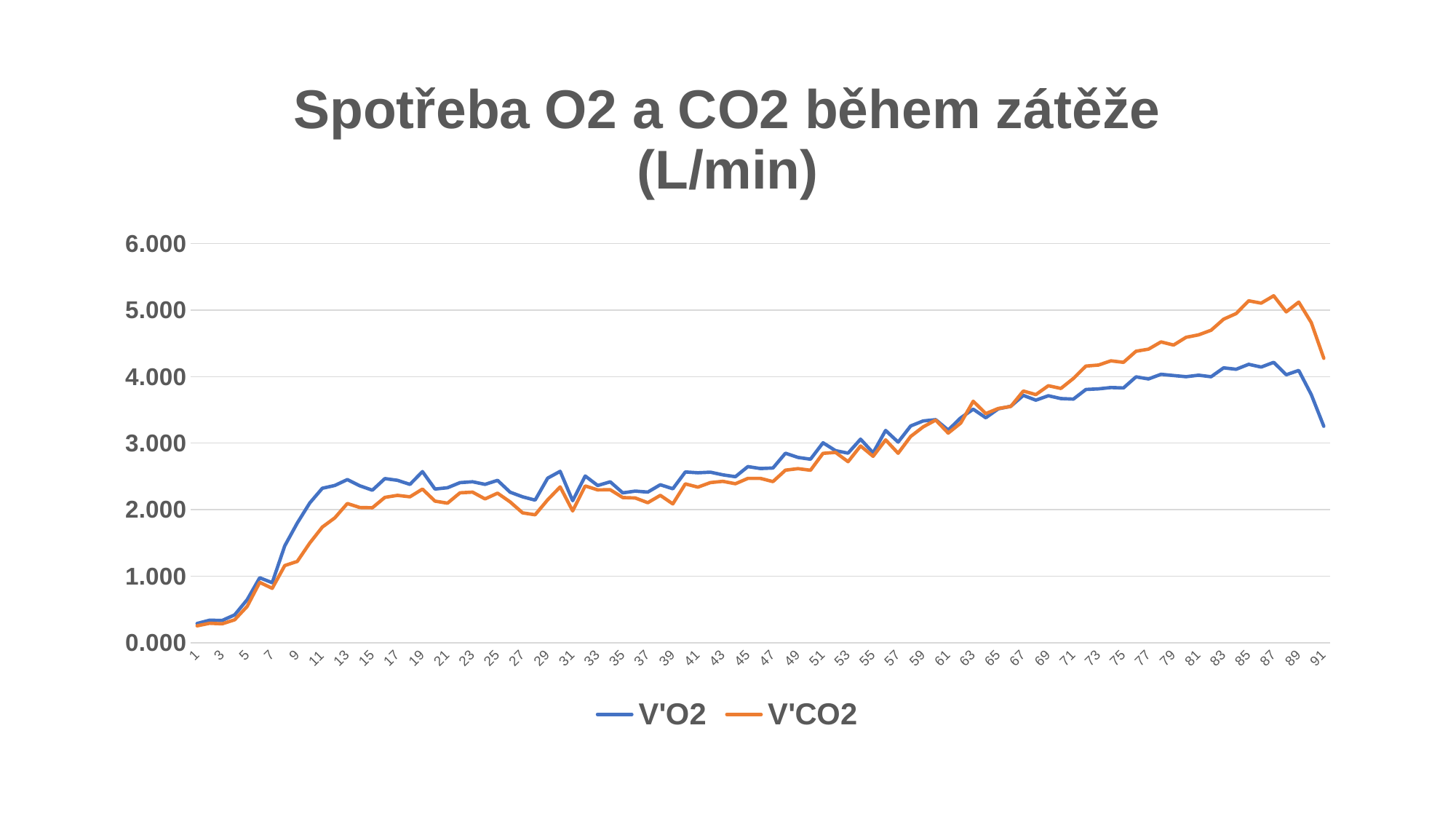
Is the value of V'CO2 at x = 87 greater or less than 5.000? greater Is the value of V'O2 at x = 91 greater or less than 3.000? greater What kind of chart is shown on the slide? line chart At x = 87, which series has the larger value, V'O2 or V'CO2? V'CO2 At x = 13, which series has the larger value, V'O2 or V'CO2? V'O2 How many series does the legend list? 2 Is the value of V'CO2 at x = 11 greater or less than 2.000? less Which series reaches the highest value anywhere on the chart? V'CO2 Which series is drawn in orange? V'CO2 Do the values of V'CO2 generally rise or fall from x = 1 to x = 87? rise What is the title of the chart? Spotřeba O2 a CO2 během zátěže (L/min)